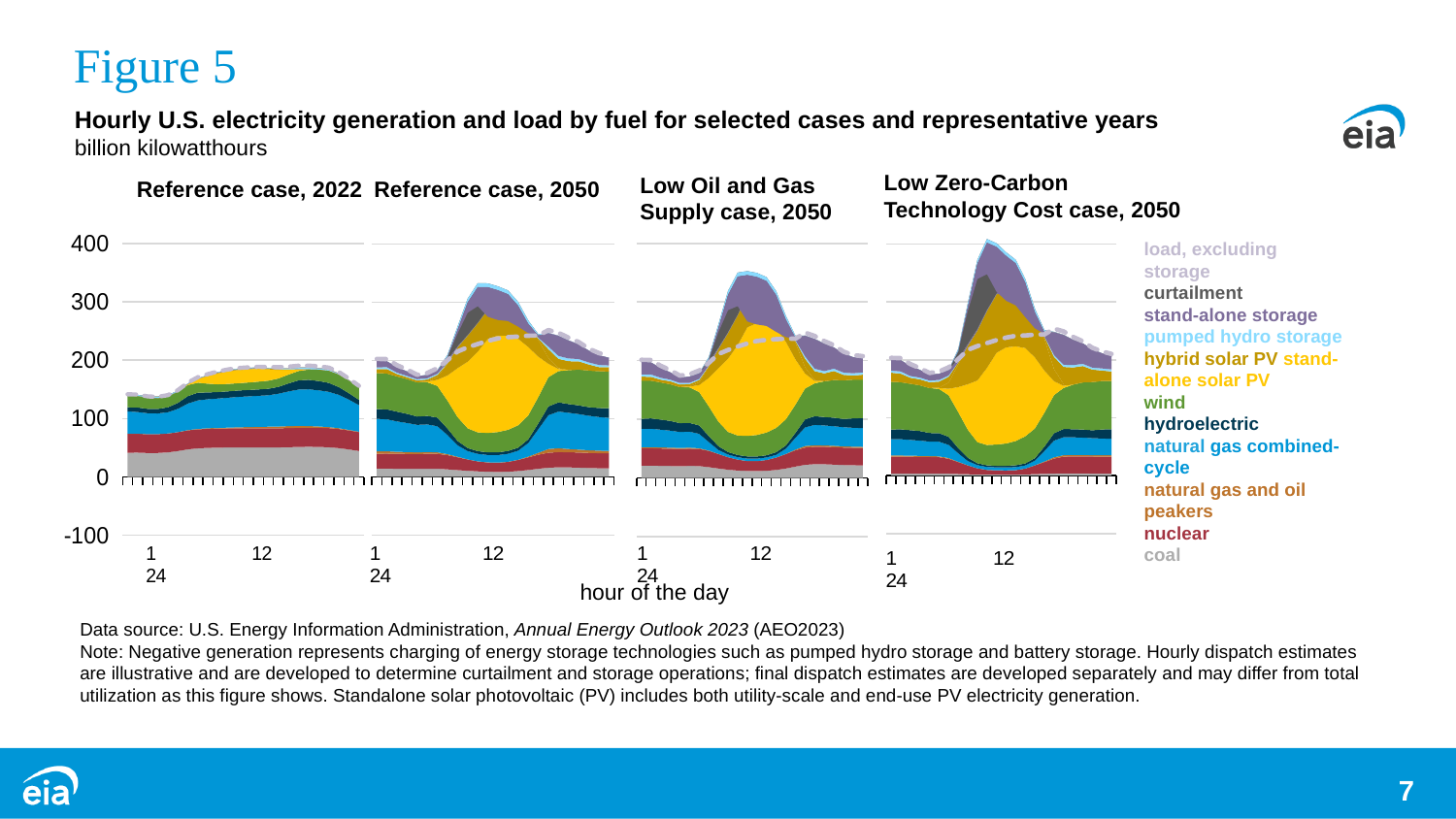
Which of the four cases shows the lowest peak total generation? Reference case, 2022 In the Low Oil and Gas Supply case, 2050 chart, is the total generation at hour 1 greater or less than 300? less In the Reference case, 2022 chart, is the total generation at hour 1 greater or less than 200? less What unit is given for the values on the charts? billion kilowatthours How many series does the legend list? 12 Which has a higher midday peak: the Reference case, 2022 chart or the Reference case, 2050 chart? Reference case, 2050 In the Reference case, 2050 chart, is the peak total generation around midday greater or less than 300? greater What kind of chart is used for each of the four panels on the slide? stacked area chart Which of the four cases shows the highest peak total generation? Low Zero-Carbon Technology Cost case, 2050 In the Reference case, 2022 chart, does total generation rise or fall from hour 1 to hour 12? rise How many chart panels (cases) are shown on the slide? 4